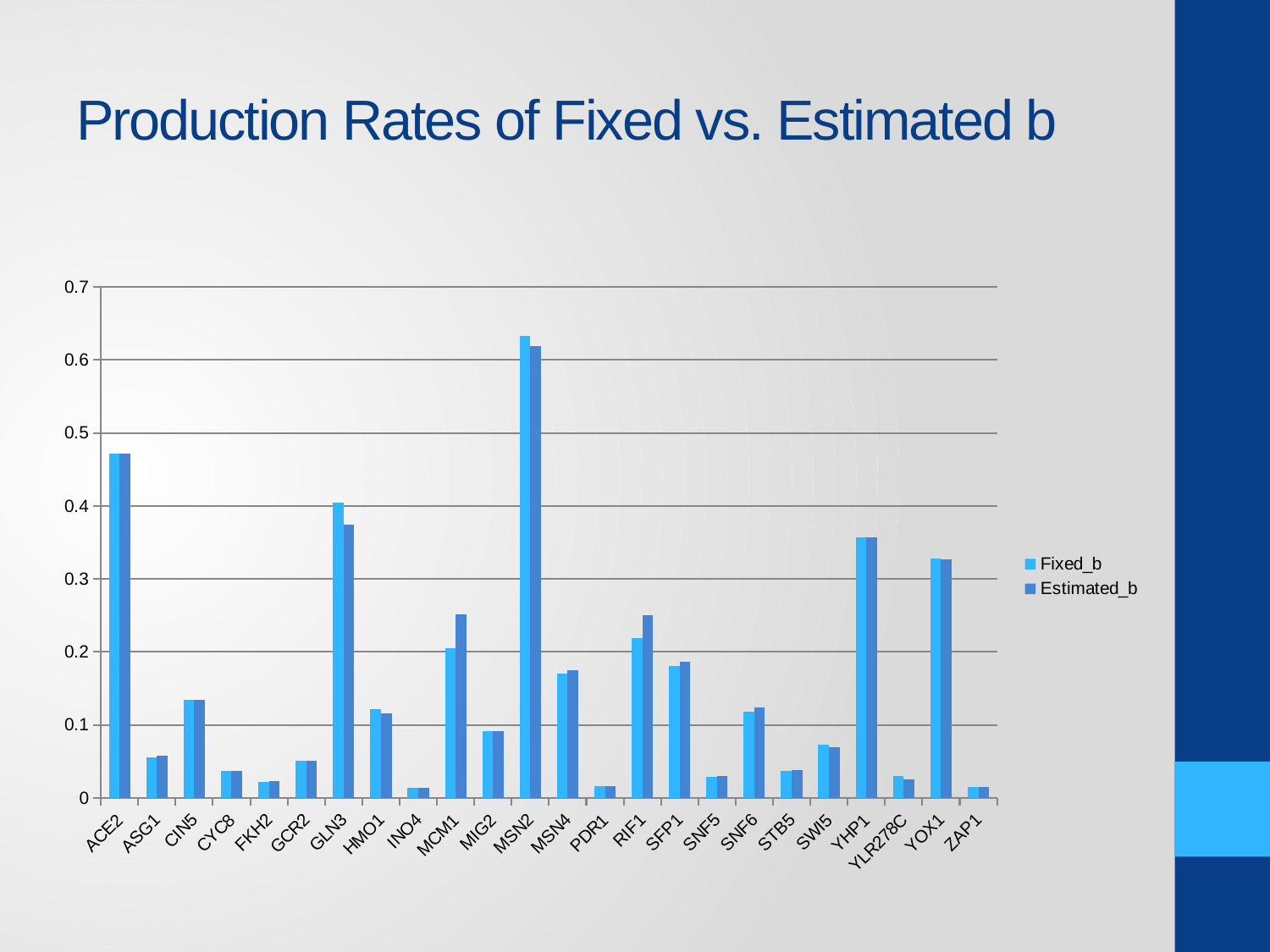
Is the Fixed_b value for MSN2 greater or less than 0.6? greater Is the Fixed_b value for ACE2 greater or less than 0.4? greater How many categories are shown on the x axis? 24 Which has the larger Fixed_b value, ACE2 or GLN3? ACE2 Which category has the highest Fixed_b value? MSN2 Is the Estimated_b value for GLN3 greater or less than 0.4? less What is the title of the chart? Production Rates of Fixed vs. Estimated b How many series does the legend list? 2 Which category has the highest Estimated_b value? MSN2 For MCM1, which series has the larger value, Fixed_b or Estimated_b? Estimated_b What kind of chart is shown on the slide? bar chart